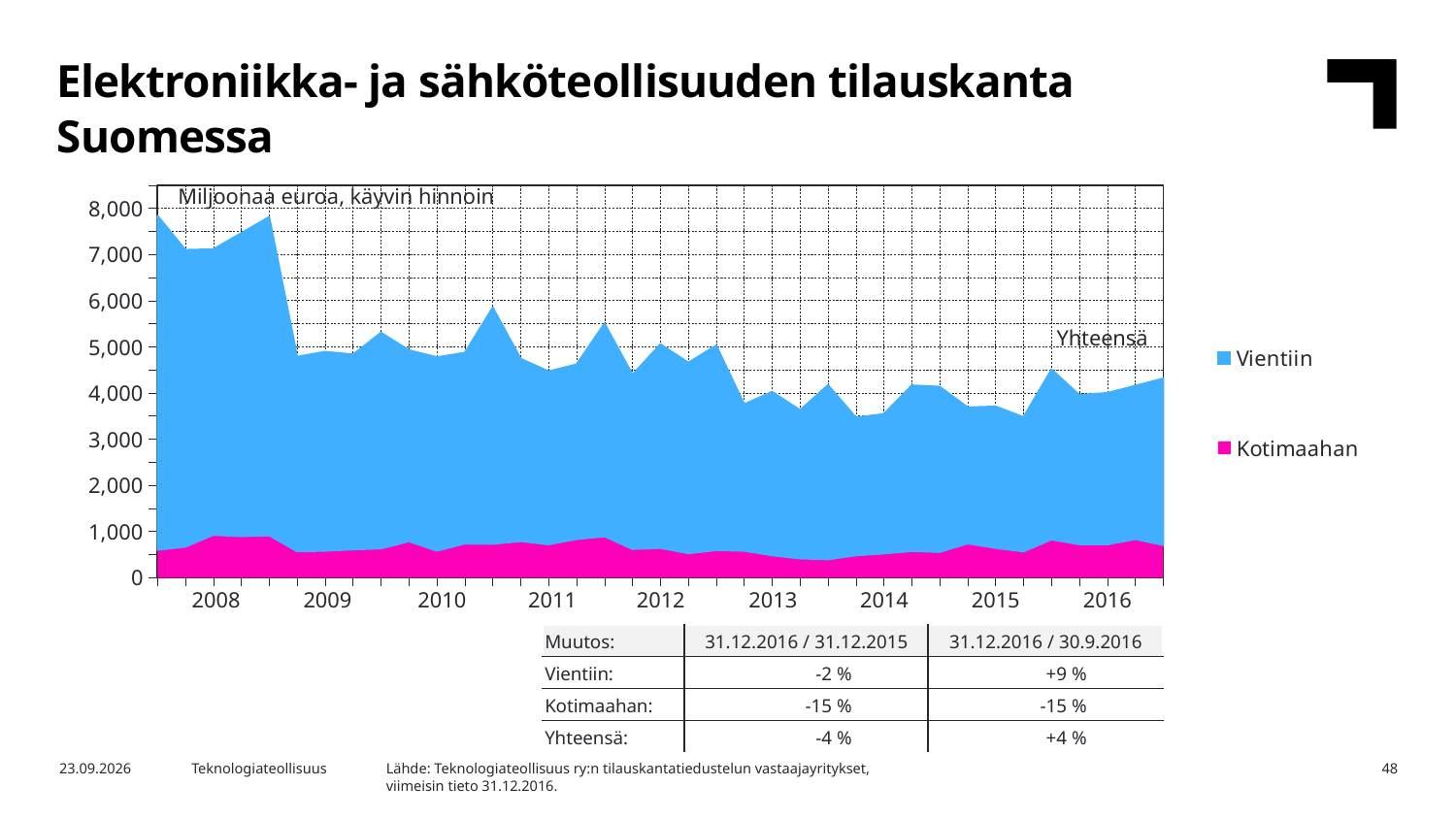
Is the total (Yhteensä) value at the start of 2008 greater or less than 7,000? greater Is the total (Yhteensä) value at the end of 2016 greater or less than 3,000? greater Does the total order backlog (Yhteensä) rise or fall overall from 2008 to 2016? fall How many series does the legend list? 2 Is the Kotimaahan value at the end of 2016 greater or less than 1,000? less Which two series are listed in the chart legend? Vientiin and Kotimaahan Which series is larger throughout the chart, Vientiin or Kotimaahan? Vientiin According to the table below the chart, what is the change in Vientiin for 31.12.2016 / 30.9.2016? +9 % What kind of chart is shown on the slide? Area chart How many years are labelled on the x axis of the chart? 9 What unit label is printed at the top of the chart? Miljoonaa euroa, käyvin hinnoin